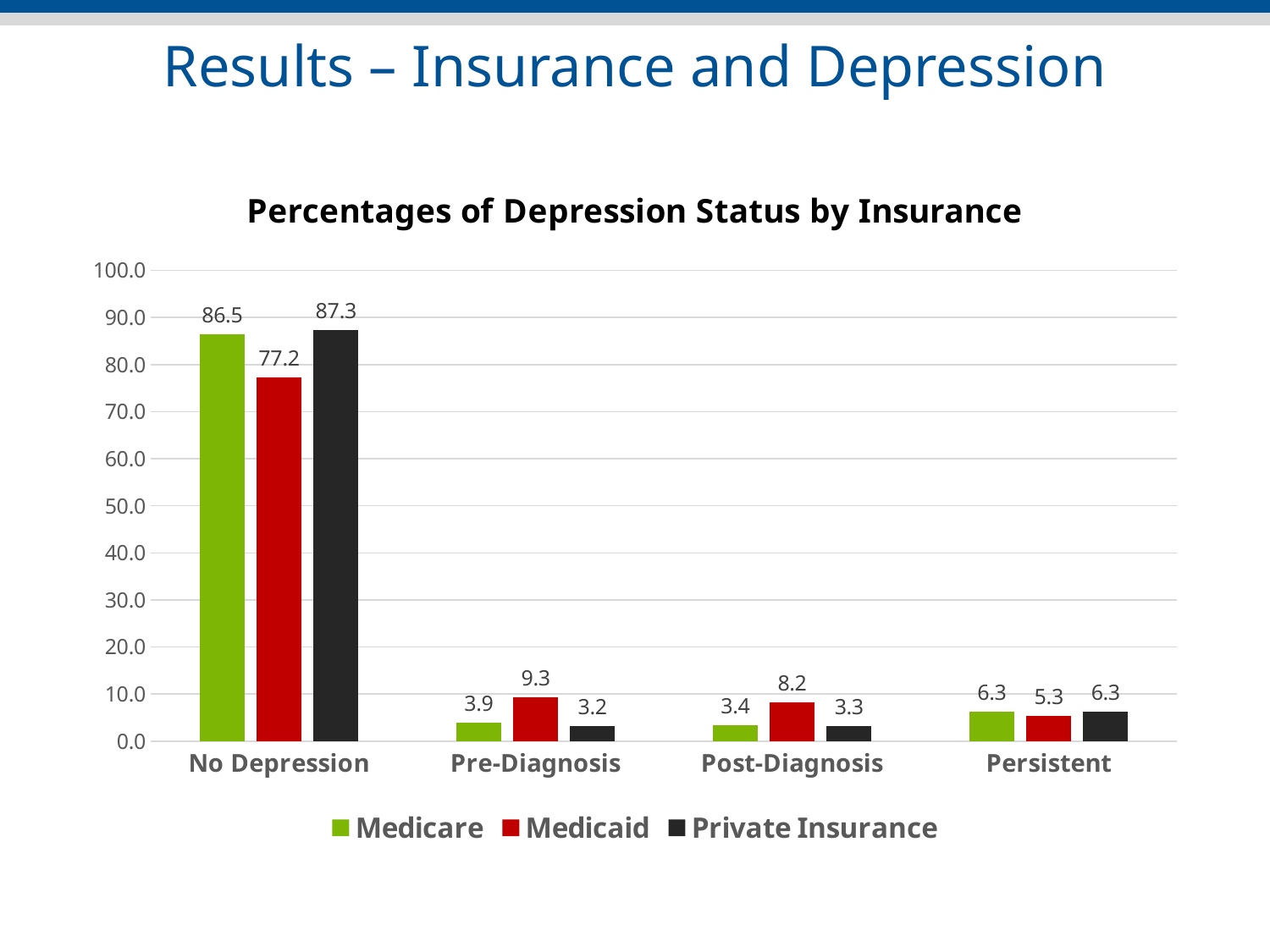
Which insurance type has the lowest value for Persistent? Medicaid What kind of chart is shown on the slide? Bar chart What is the title of the chart? Percentages of Depression Status by Insurance What is the difference between the Medicaid and Medicare values for Pre-Diagnosis? 5.4 How many series does the legend list? 3 Which colour represents Medicaid in the chart? Red What is the Medicare value for Post-Diagnosis? 3.4 What is the Private Insurance value for Pre-Diagnosis? 3.2 What is the Medicaid value for No Depression? 77.2 How many depression status categories are shown on the x axis? 4 Which is larger for Post-Diagnosis, the Medicaid value or the Private Insurance value? Medicaid Which insurance type has the highest value for No Depression? Private Insurance